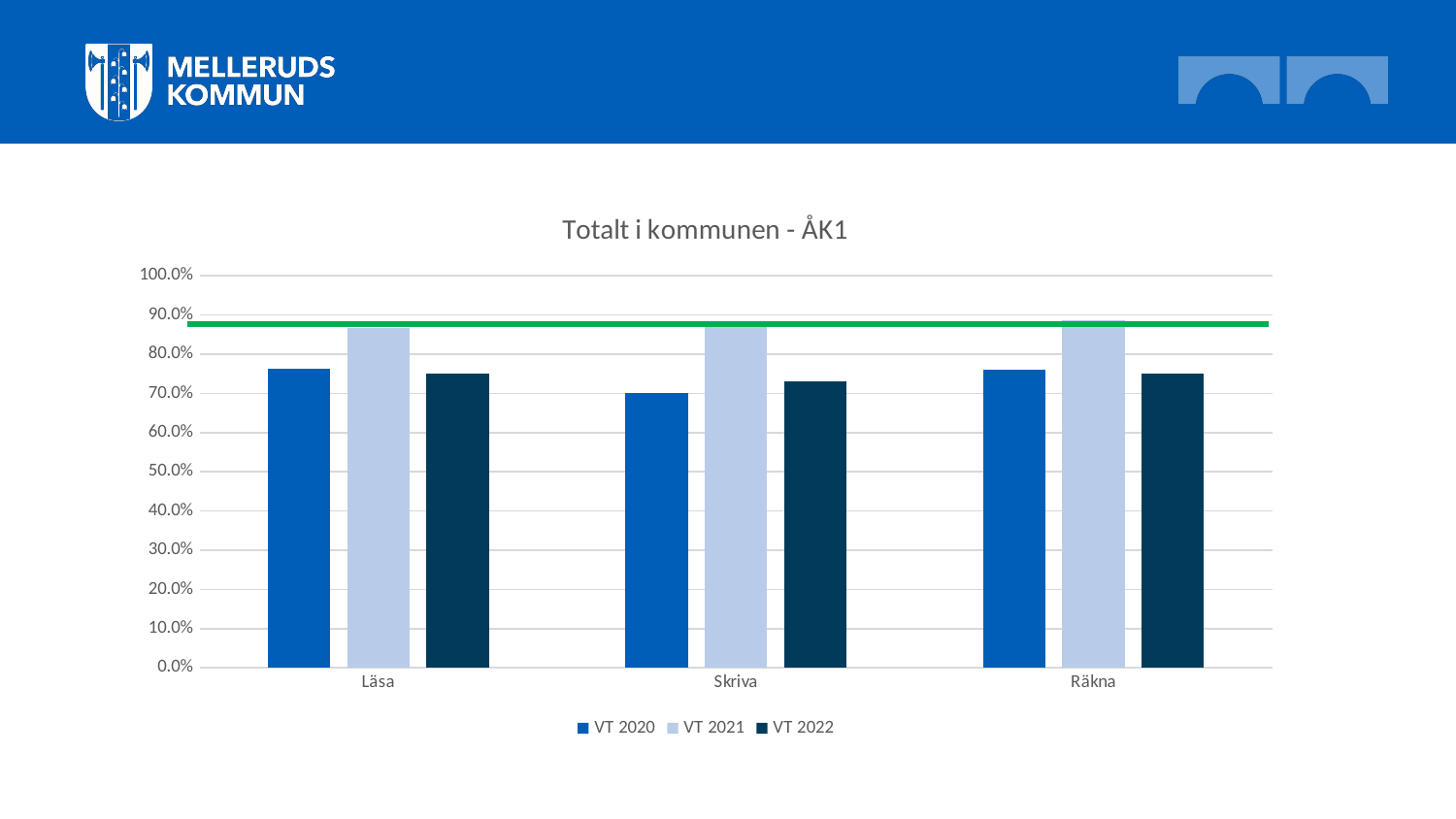
For the category Skriva, which is larger: the value for VT 2021 or the value for VT 2022? VT 2021 For the series VT 2020, which category has the lowest bar? Skriva Is the value for VT 2020 in the category Skriva greater or less than 80.0%? less What is the title of the chart? Totalt i kommunen - ÅK1 How many series does the chart's legend list? 3 For the category Läsa, which series has the highest bar? VT 2021 What kind of chart is shown on the slide? Bar chart How many categories are shown on the x axis of the chart? 3 Is the value for VT 2021 in the category Läsa greater or less than 80.0%? greater Which series are listed in the chart's legend? VT 2020, VT 2021, VT 2022 For the category Räkna, which is larger: the value for VT 2020 or the value for VT 2021? VT 2021 Is the value for VT 2022 in the category Räkna greater or less than 80.0%? less